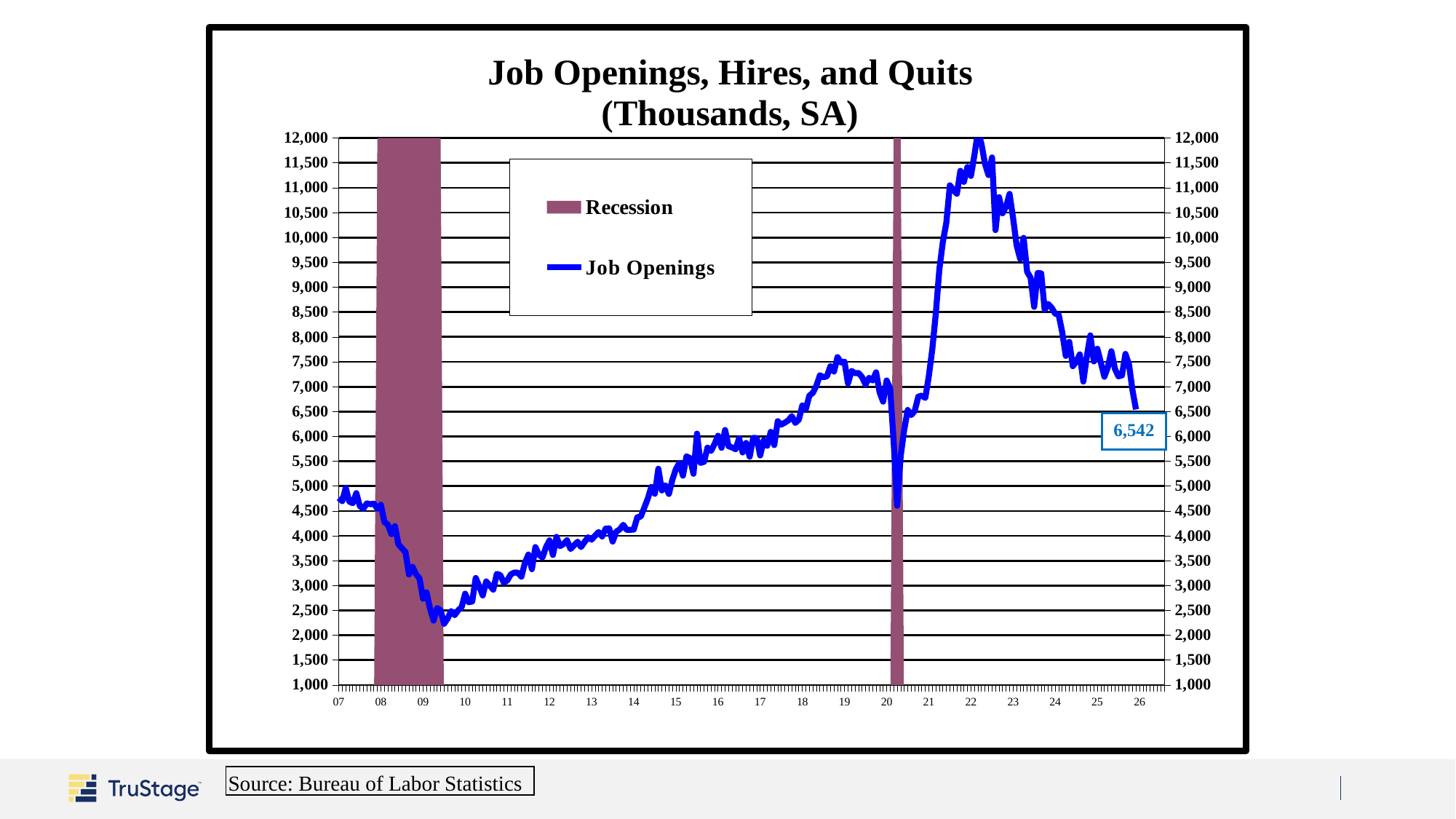
Is the value of Job Openings at the start of 2023 greater or less than 10,000? greater In which year does the Job Openings line reach its lowest point? 09 How many entries does the legend list? 2 What is the value of the last data label shown on the Job Openings line? 6,542 Is the peak value of Job Openings in 2022 greater or less than 11,500? greater Which is larger: the peak of Job Openings in 2022 or the peak in 2019? 2022 What is the title of the chart? Job Openings, Hires, and Quits (Thousands, SA) What kind of chart is shown on the slide? line chart In which year does the Job Openings line reach its highest point? 22 Is the lowest value of Job Openings in 2009 greater or less than 2,500? less Do Job Openings rise or fall between 2022 and 2026? fall